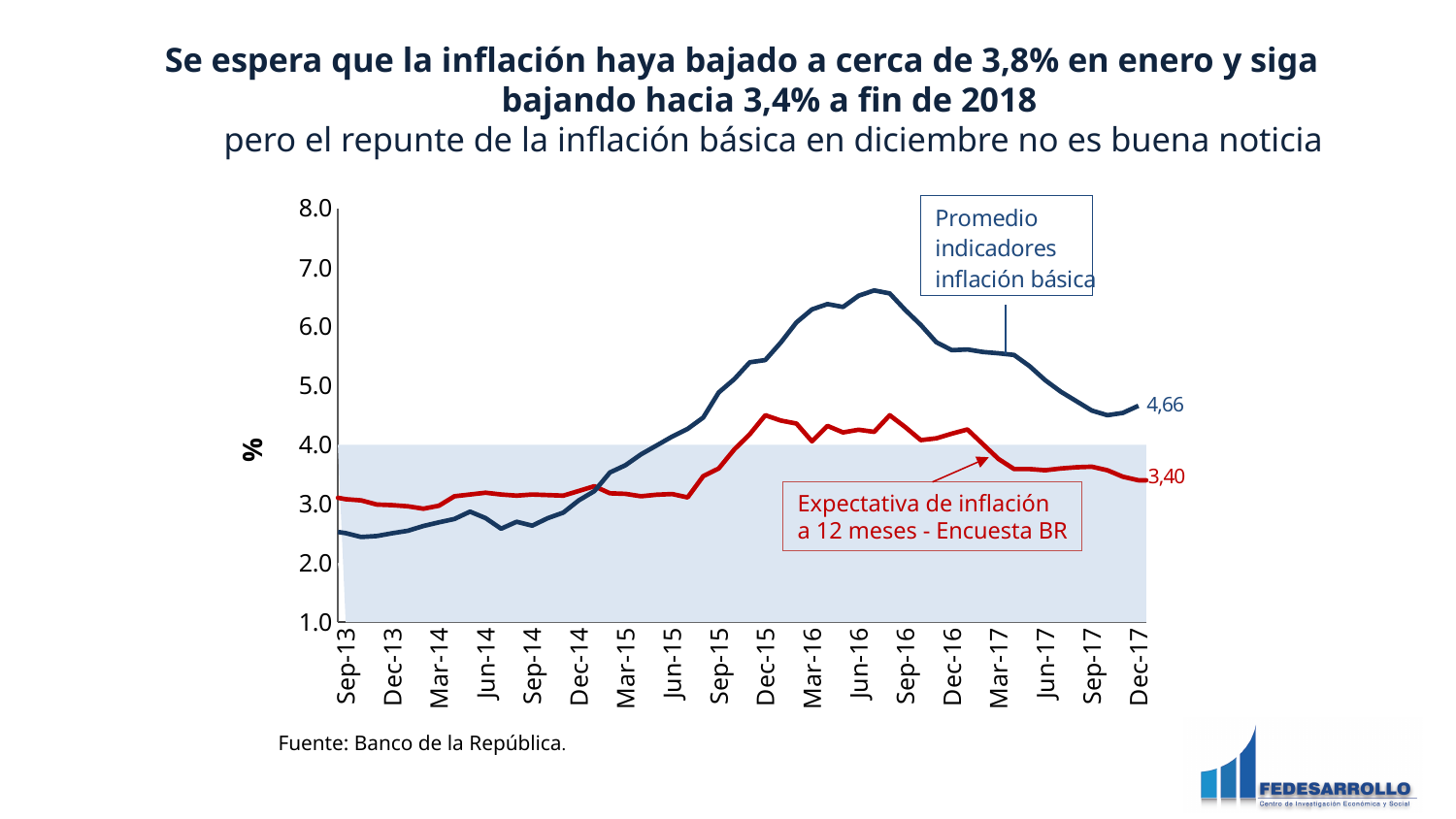
What is the value of the Promedio indicadores inflación básica series at Dec-17? 4,66 What source is cited below the chart? Banco de la República Is the value of the Expectativa de inflación a 12 meses - Encuesta BR series at Sep-13 greater or less than 4.0? less How many series are plotted on the chart? 2 At Dec-17, which series has the higher value: Promedio indicadores inflación básica or Expectativa de inflación a 12 meses - Encuesta BR? Promedio indicadores inflación básica Is the value of the Promedio indicadores inflación básica series at Sep-13 greater or less than 3.0? less What is the value of the Expectativa de inflación a 12 meses - Encuesta BR series at Dec-17? 3,40 Does the Promedio indicadores inflación básica series rise or fall between Jun-16 and Dec-17? fall Is the value of the Expectativa de inflación a 12 meses - Encuesta BR series at Dec-15 greater or less than 4.0? greater What kind of chart is shown on the slide? line chart What is the difference between the Promedio indicadores inflación básica value and the Expectativa de inflación a 12 meses value at Dec-17? 1,26